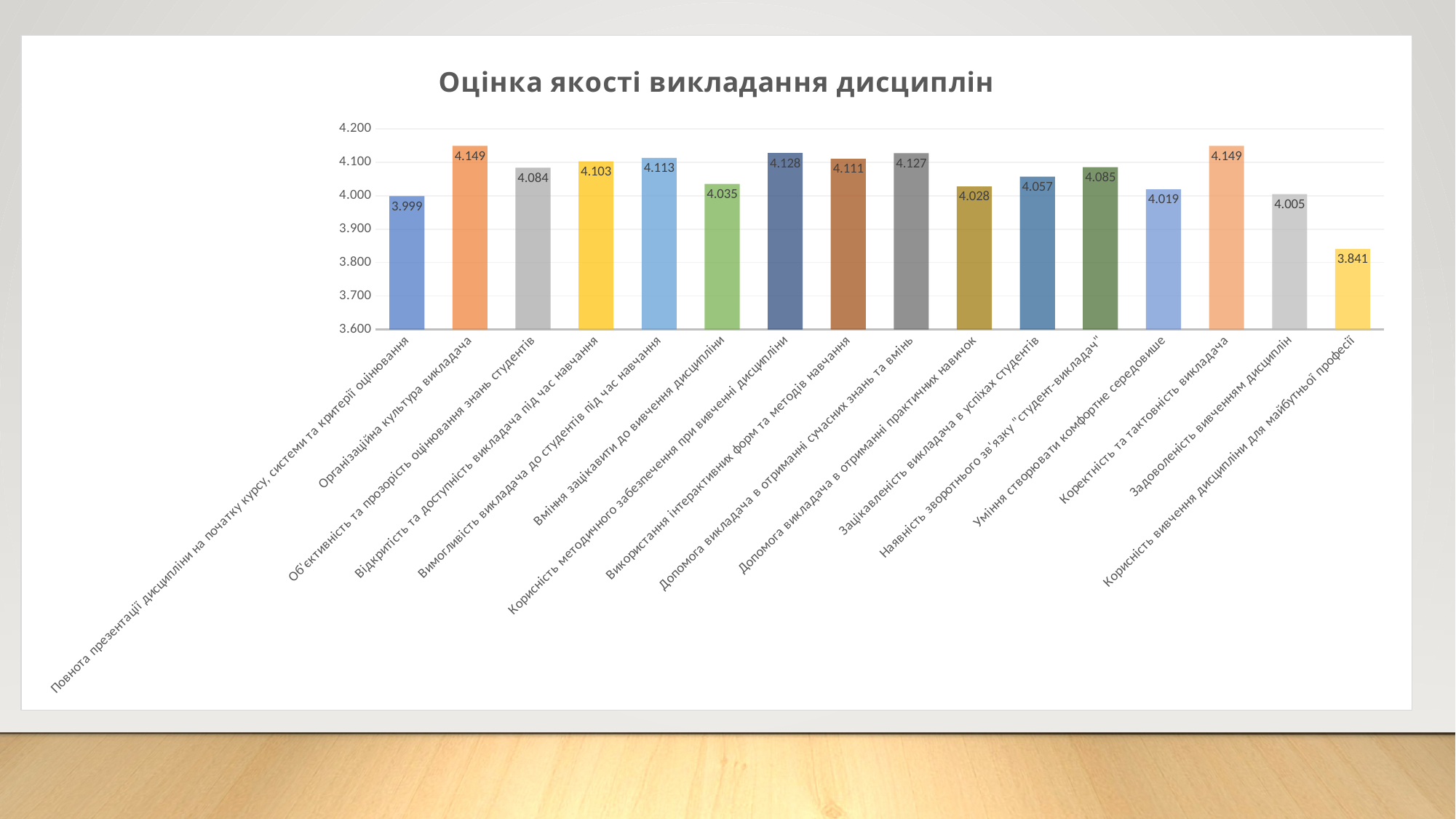
What is the highest value shown on the chart? 4.149 Which category has the lowest value? Корисність вивчення дисципліни для майбутньої професії What kind of chart is shown on the slide? bar chart What is the value for "Уміння створювати комфортне середовише"? 4.019 What is the value for "Вміння зацікавити до вивчення дисципліни"? 4.035 What is the value for "Задоволеність вивченням дисциплін"? 4.005 Which is larger: the value for "Вимогливість викладача до студентів під час навчання" or the value for "Зацікавленість викладача в успіхах студентів"? Вимогливість викладача до студентів під час навчання What is the difference between the values for "Корисність методичного забезпечення при вивченні дисципліни" and "Корисність вивчення дисципліни для майбутньої професії"? 0.287 Is the value for "Повнота презентації дисципліни на початку курсу, системи та критерії оцінювання" greater or less than 4.000? less What is the value for "Організаційна культура викладача"? 4.149 What is the title of the chart? Оцінка якості викладання дисциплін How many categories are shown on the chart? 16